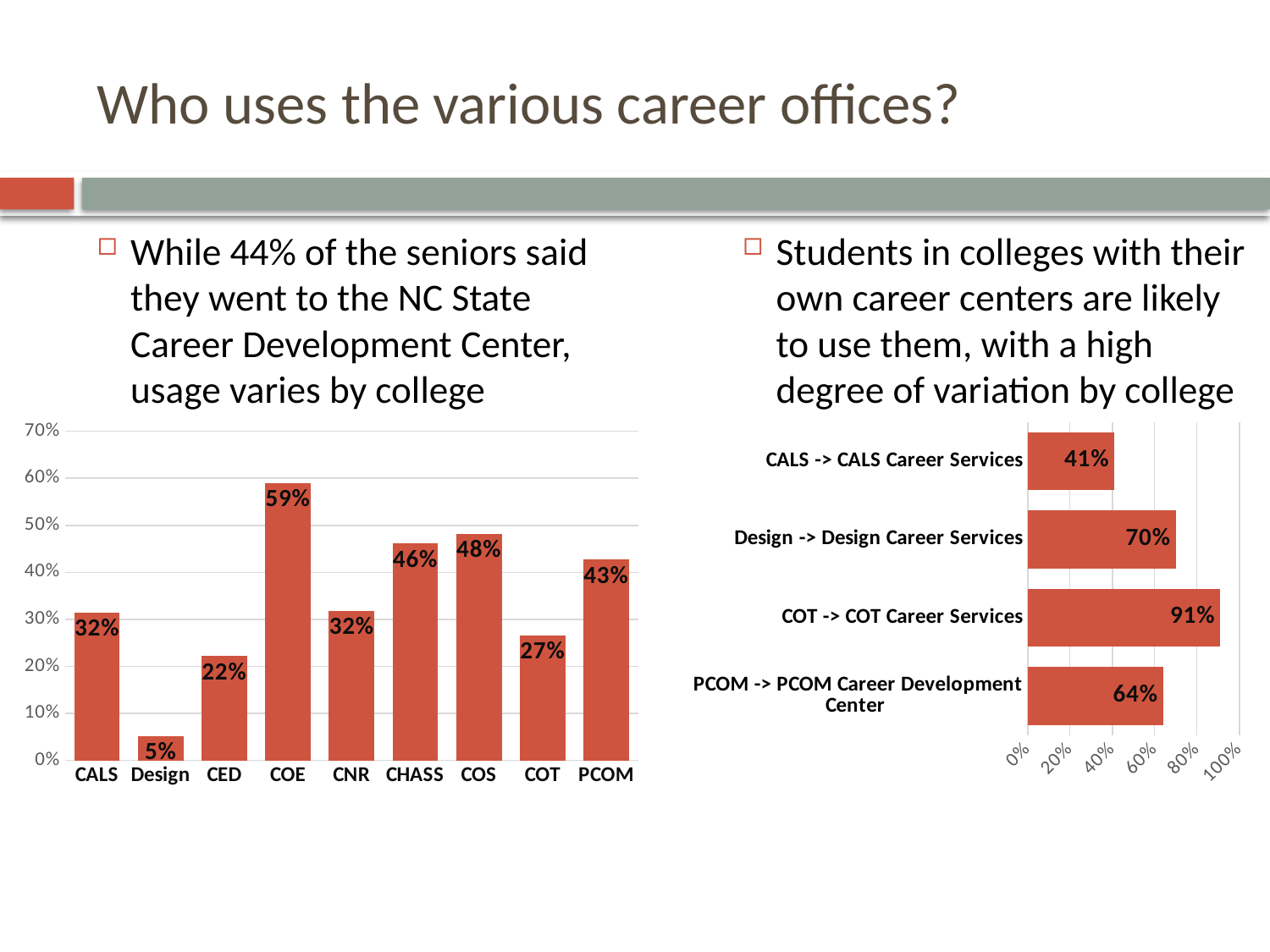
In the left chart, which college has the lowest value? Design How many colleges are shown on the x axis of the left chart? 9 In the left chart, which college has the highest value? COE How many bars are in the right chart? 4 In the right chart, which category has the lowest value? CALS -> CALS Career Services In the right chart, what is the difference between the values for Design -> Design Career Services and PCOM -> PCOM Career Development Center? 6% In the left chart, what is the value for Design? 5% In the left chart, what percentage is shown for COE? 59% What kind of chart is the left chart? Bar chart In the left chart, what is the difference between the values for COS and COT? 21% In the left chart, which is larger, the value for CHASS or the value for PCOM? CHASS In the right chart, what percentage is shown for COT -> COT Career Services? 91%